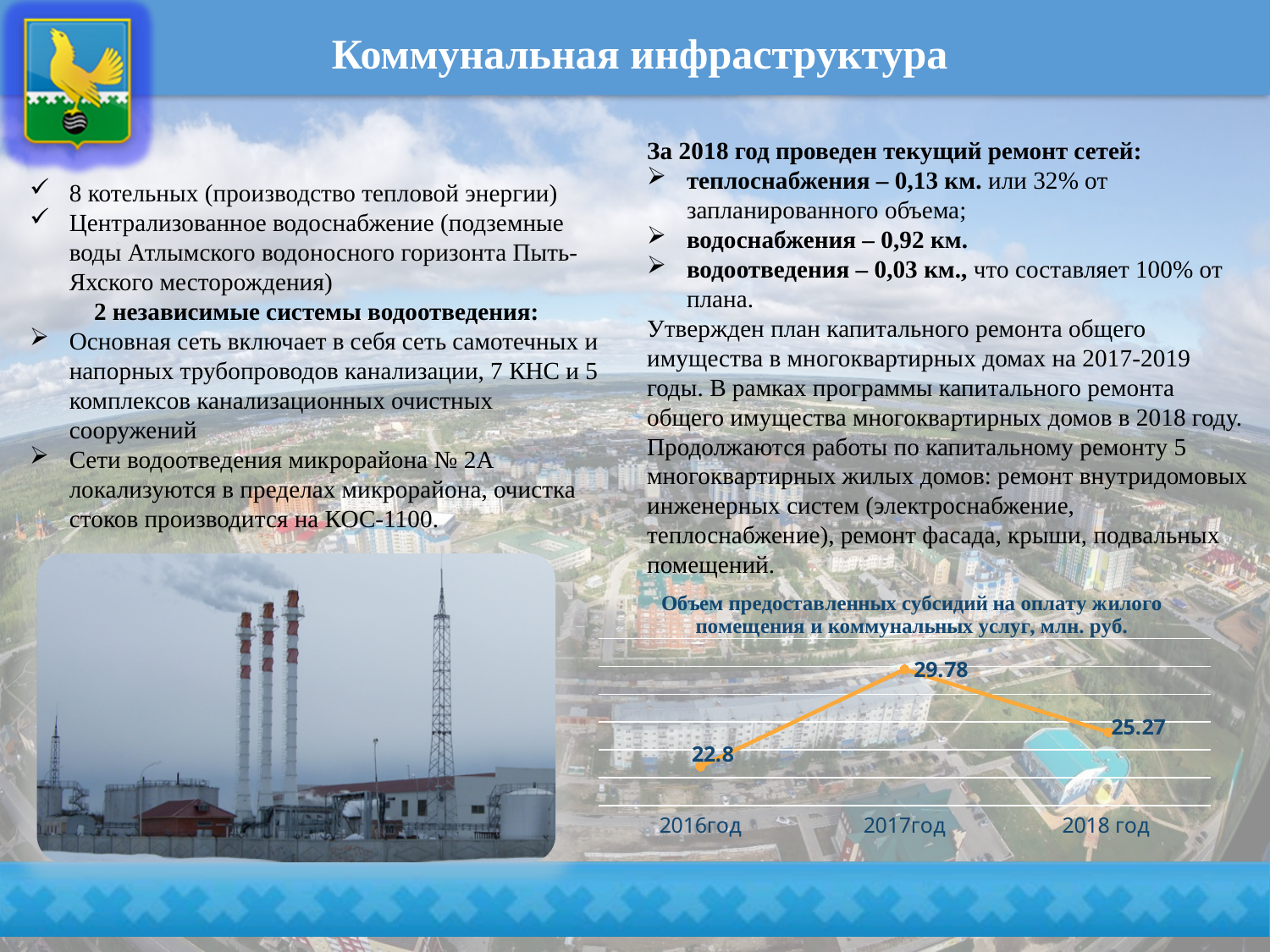
Which year has the lowest value on the chart? 2016год Which is larger, the value for 2018 год or the value for 2016год? 2018 год Which year has the highest value on the chart? 2017год Does the value rise or fall from 2017год to 2018 год? fall What kind of chart is shown on the slide? line chart What is the difference between the values for 2017год and 2016год? 6.98 What is the difference between the values for 2017год and 2018 год? 4.51 What is the value for 2018 год on the chart? 25.27 What is the value for 2017год on the chart? 29.78 What is the value for 2016год on the chart? 22.8 How many data points are plotted on the chart? 3 What is the title of the chart? Объем предоставленных субсидий на оплату жилого помещения и коммунальных услуг, млн. руб.